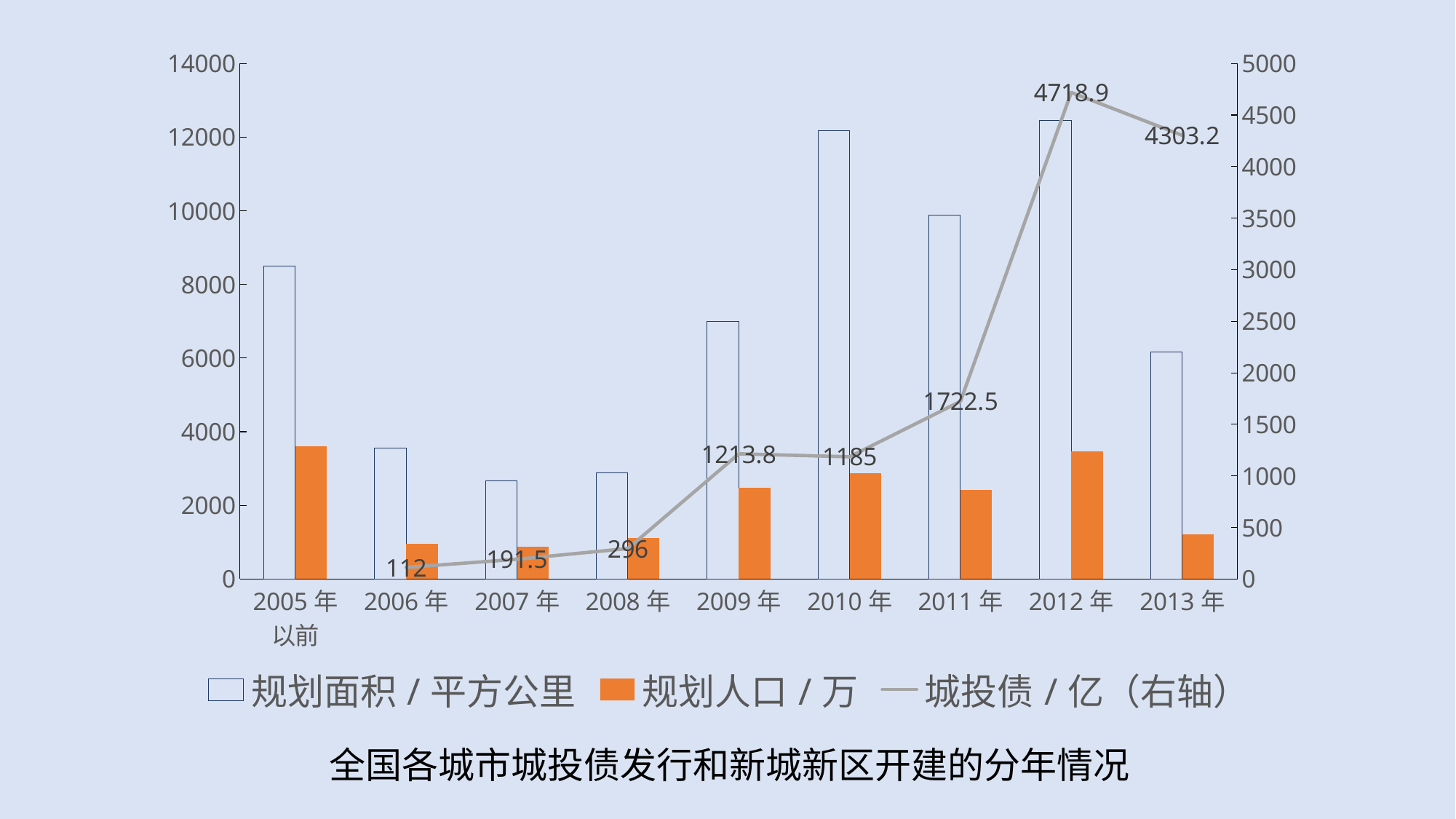
Is the 规划人口 / 万 value for 2005 年以前 greater or less than 4000? less How many year categories are shown on the x axis? 9 What is the value of 城投债 / 亿 for 2006 年? 112 Is the 规划面积 / 平方公里 value for 2009 年 greater or less than 6000? greater In which year is 城投债 / 亿 highest? 2012 年 Among the labelled years, in which year is 城投债 / 亿 lowest? 2006 年 What is the title of the chart? 全国各城市城投债发行和新城新区开建的分年情况 What is the value of 城投债 / 亿 for 2012 年? 4718.9 How many series does the legend list? 3 Which year has the larger 城投债 / 亿 value, 2009 年 or 2010 年? 2009 年 What is the difference in 城投债 / 亿 between 2012 年 and 2013 年? 415.7 What is the value of 城投债 / 亿 for 2009 年? 1213.8